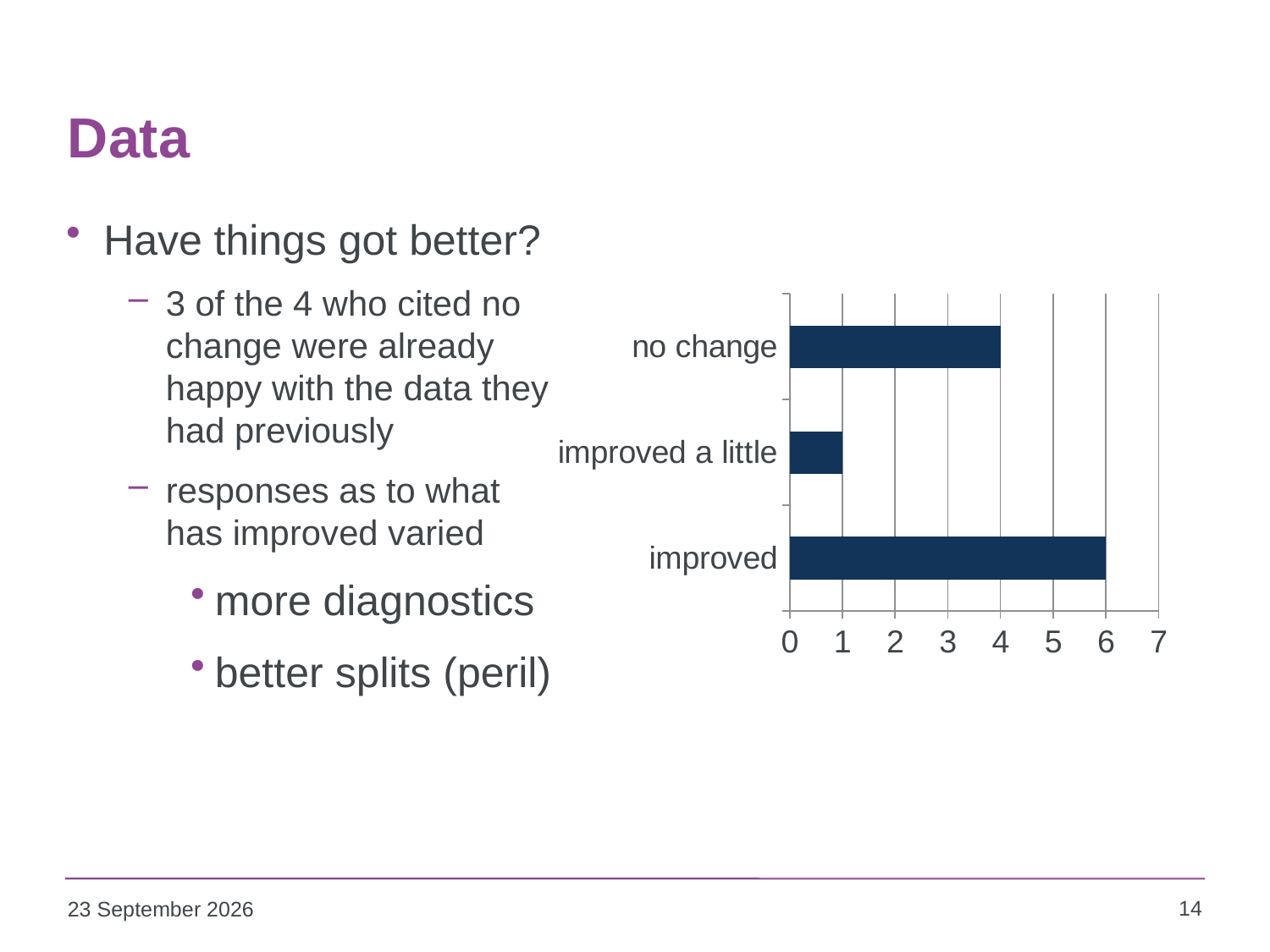
What is the difference between the values for "improved" and "no change"? 2 What is the value for "improved a little"? 1 Is the value for "improved" greater or less than 5? greater What kind of chart is shown on the slide? bar chart What is the difference between the values for "no change" and "improved a little"? 3 Which category has the highest value? improved How many categories does the chart show? 3 Which category has the lowest value? improved a little What is the value for "no change"? 4 Which is larger, the value for "no change" or the value for "improved a little"? no change What is the value for "improved"? 6 What is the highest value shown on the x axis? 7